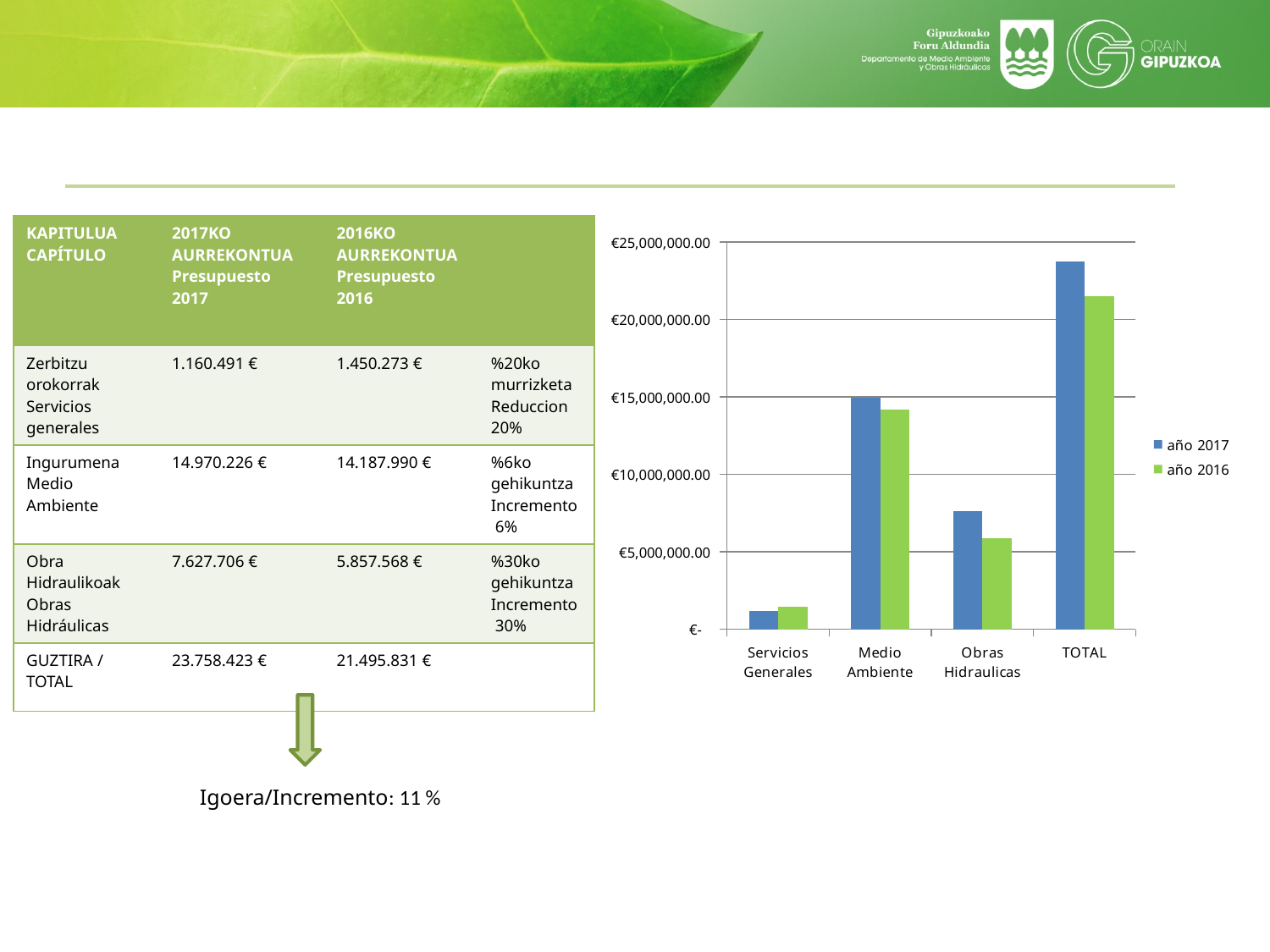
Which category has the highest bar for año 2017? TOTAL For Obras Hidraulicas, which series has the larger value, año 2017 or año 2016? año 2017 Is the año 2017 value for Servicios Generales greater or less than €5,000,000.00? less What are the two entries listed in the chart legend? año 2017 and año 2016 What kind of chart is shown on the slide? bar chart Is the año 2017 value for TOTAL greater or less than €20,000,000.00? greater Which category has the lowest bar for año 2016? Servicios Generales How many categories are shown on the x axis of the chart? 4 For Servicios Generales, which series has the larger value, año 2017 or año 2016? año 2016 For TOTAL, which series has the larger value, año 2017 or año 2016? año 2017 How many series does the chart legend list? 2 Is the año 2016 value for Obras Hidraulicas greater or less than €10,000,000.00? less